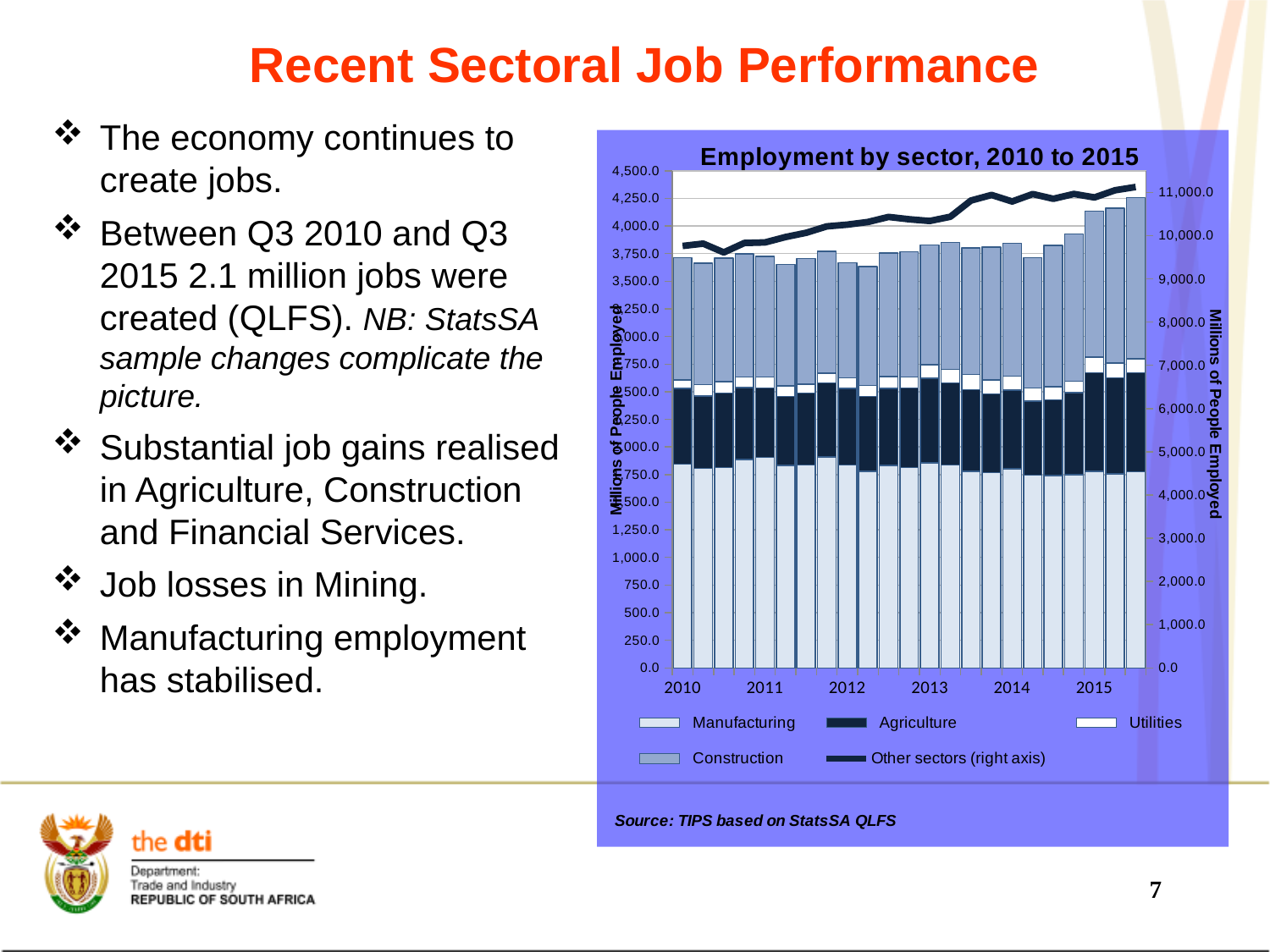
In the 'Employment by sector, 2010 to 2015' chart, does the 'Other sectors (right axis)' line rise or fall from 2010 to 2015? Rise In the 'Employment by sector, 2010 to 2015' chart, is the total height of the first stacked bar in 2010 greater or less than 4,000.0 on the left axis? less In the 'Employment by sector, 2010 to 2015' chart, is the Manufacturing segment of the first 2010 bar greater or less than 1,500.0 on the left axis? greater Which series in the 'Employment by sector, 2010 to 2015' chart is plotted on the right axis? Other sectors In the 'Employment by sector, 2010 to 2015' chart, which year has the tallest stacked bars? 2015 What is the source given below the 'Employment by sector, 2010 to 2015' chart? TIPS based on StatsSA QLFS How many year labels appear on the x axis of the 'Employment by sector, 2010 to 2015' chart? 6 How many series does the legend of the 'Employment by sector, 2010 to 2015' chart list? 5 What kind of chart is 'Employment by sector, 2010 to 2015'? Stacked bar chart with a line In the 'Employment by sector, 2010 to 2015' chart, is the total height of the last stacked bar in 2015 greater or less than 4,000.0 on the left axis? greater